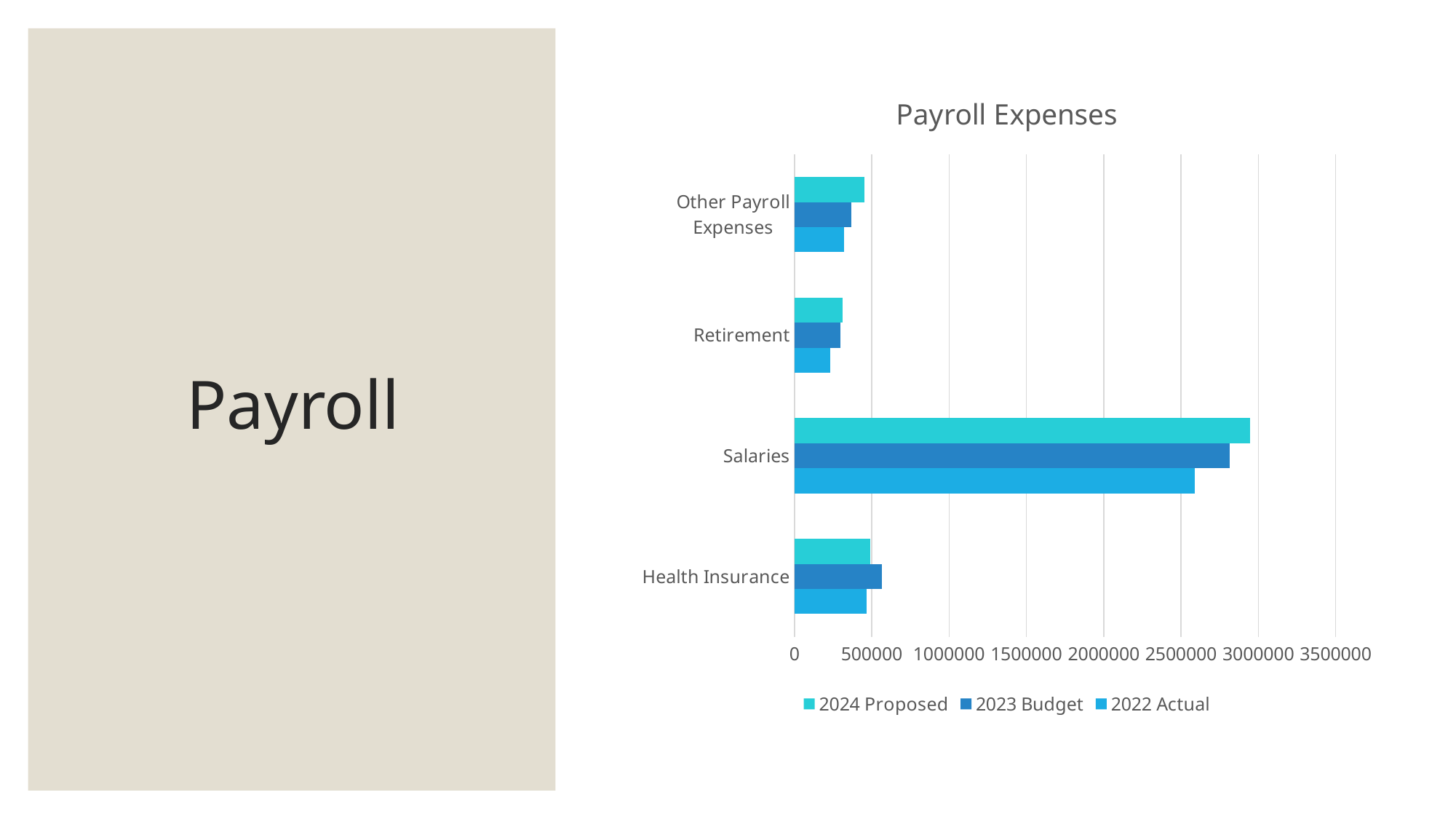
For Health Insurance, which is larger: the 2023 Budget value or the 2024 Proposed value? 2023 Budget What type of chart is shown on the slide? bar chart How many categories are shown on the chart? 4 What is the title of the chart? Payroll Expenses Which series is listed first in the legend? 2024 Proposed Is the 2023 Budget value for Health Insurance greater or less than 500000? greater Which category has the highest values across all series? Salaries Is the 2024 Proposed value for Salaries greater or less than 2500000? greater Is the 2022 Actual value for Retirement greater or less than 500000? less For Salaries, which is larger: the 2024 Proposed value or the 2022 Actual value? 2024 Proposed Which category has the lowest 2022 Actual value? Retirement How many series does the legend list? 3